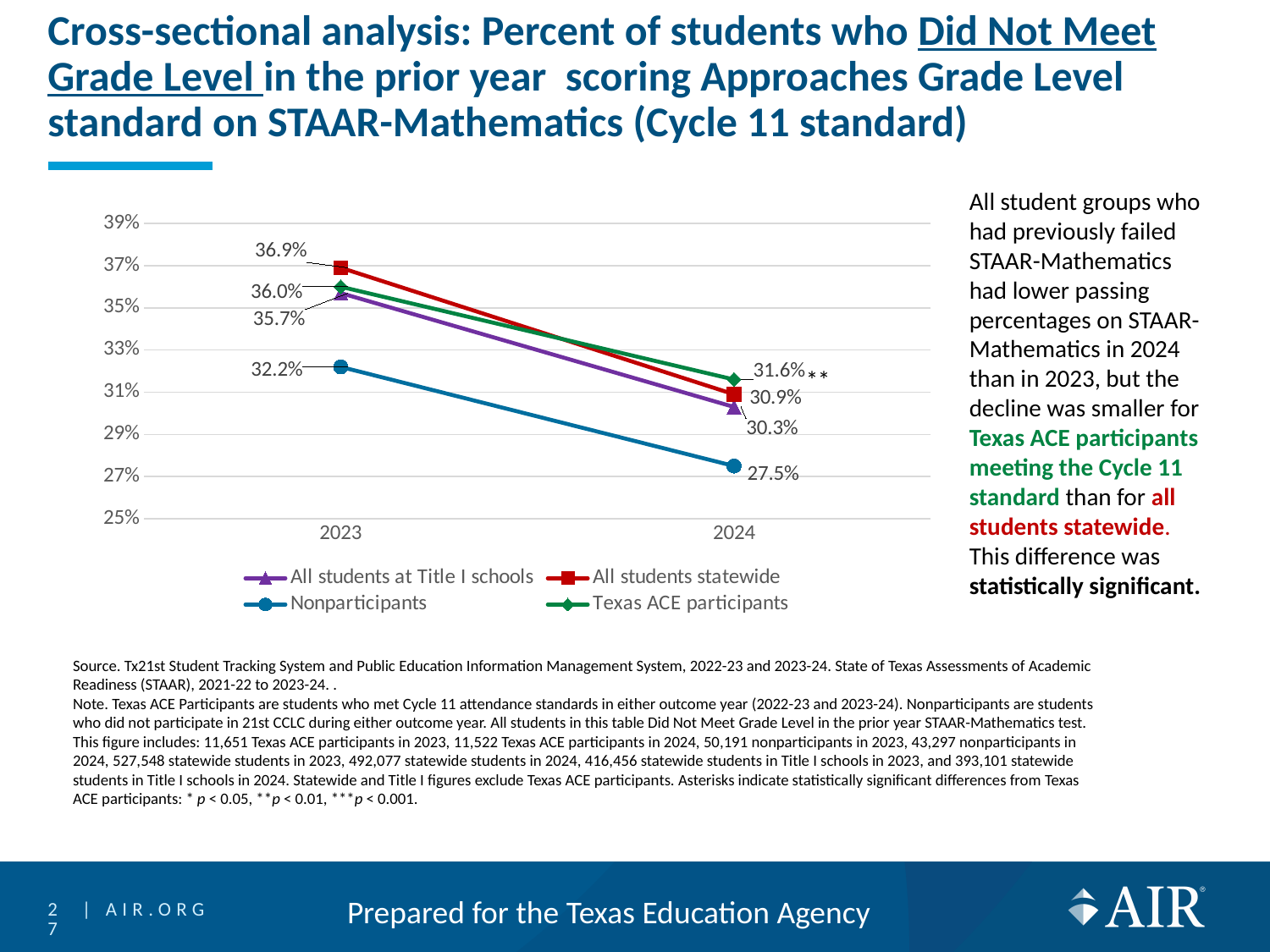
Which series has the highest value in 2024? Texas ACE participants In 2024, which is larger: the value for All students statewide or the value for All students at Title I schools? All students statewide What kind of chart is shown on the slide? Line chart By how many percentage points did the value for Texas ACE participants fall from 2023 to 2024? 4.4 percentage points Do the values for Nonparticipants rise or fall from 2023 to 2024? Fall By how many percentage points did the value for All students statewide fall from 2023 to 2024? 6.0 percentage points What is the value for All students statewide in 2023? 36.9% What is the value for Texas ACE participants in 2024? 31.6% How many series does the legend list? 4 Which series has the lowest value in 2023? Nonparticipants What is the value for All students at Title I schools in 2024? 30.3% What is the value for Nonparticipants in 2023? 32.2%